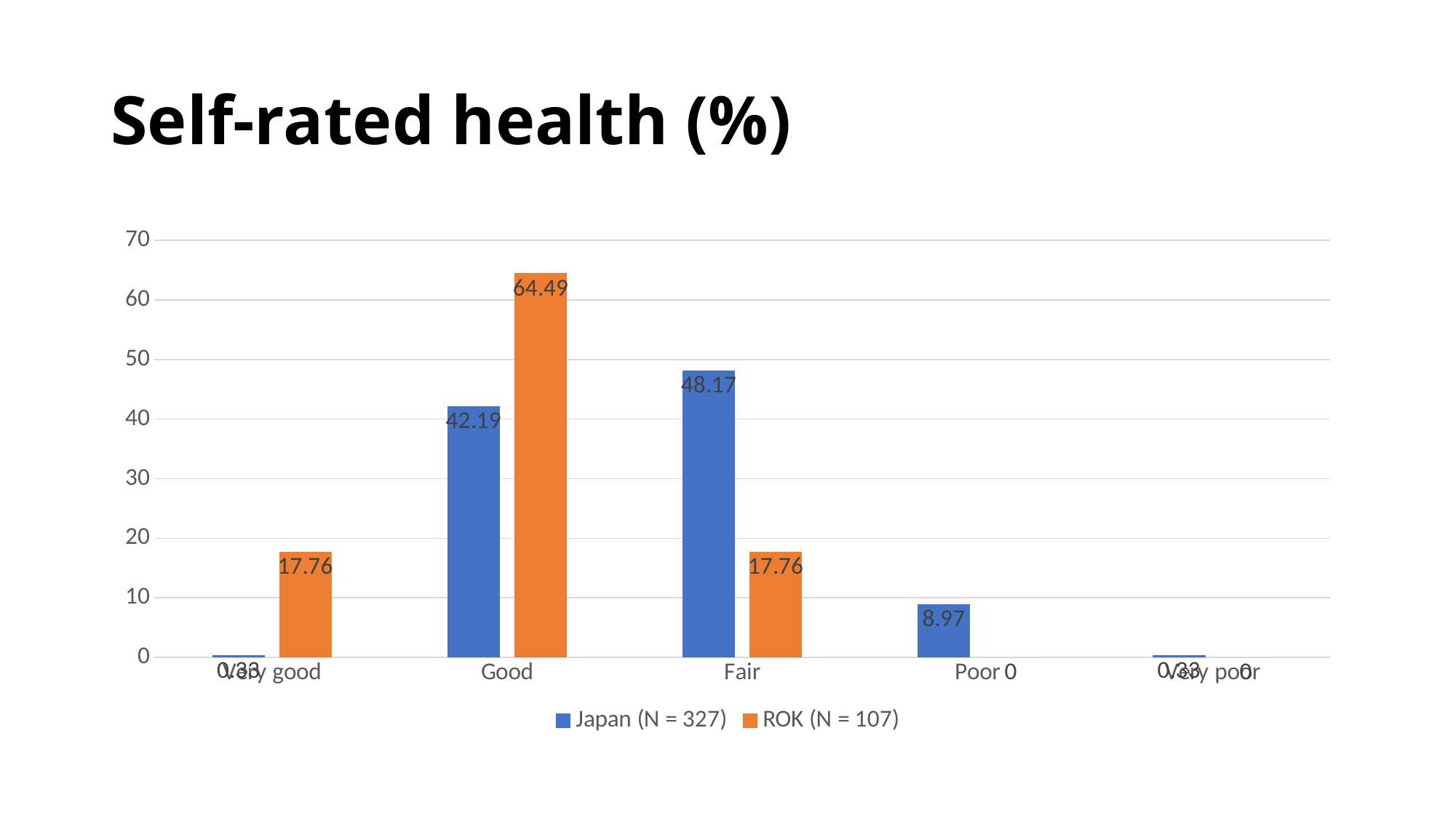
What is the value for Japan (N = 327) in the Fair category? 48.17 How many categories are shown on the x axis? 5 Which category has the highest value for Japan (N = 327)? Fair What is the difference between the ROK (N = 107) and Japan (N = 327) values in the Good category? 22.30 What is the value for ROK (N = 107) in the Good category? 64.49 What is the value for Japan (N = 327) in the Poor category? 8.97 How many series does the legend list? 2 Which category has the highest value for ROK (N = 107)? Good What kind of chart is shown on the slide? Bar chart What is the value for ROK (N = 107) in the Very good category? 17.76 What is the value for ROK (N = 107) in the Poor category? 0 In the Fair category, which series has the larger value, Japan (N = 327) or ROK (N = 107)? Japan (N = 327)